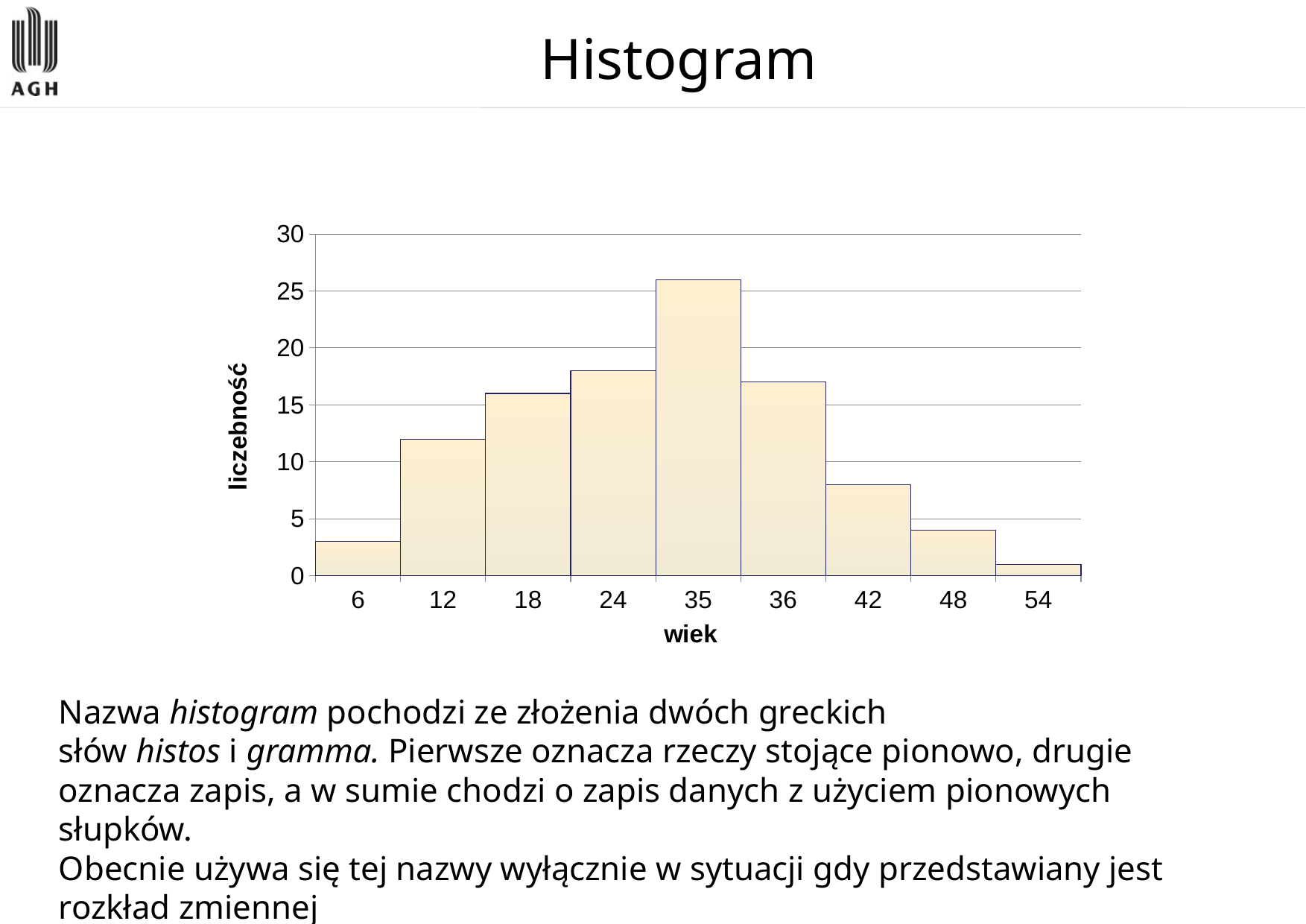
What is the label of the vertical axis? liczebność What kind of chart is shown on the slide? bar chart Which has a larger value, wiek 12 or wiek 42? 12 How many bars does the chart have? 9 Is the value for wiek 35 greater or less than 25? greater Which wiek category has the highest liczebność? 35 Do the values rise or fall from wiek 35 to wiek 54? fall Which has a larger value, wiek 12 or wiek 18? 18 Which wiek category has the lowest liczebność? 54 Is the value for wiek 24 greater or less than 15? greater Is the value for wiek 42 greater or less than 10? less